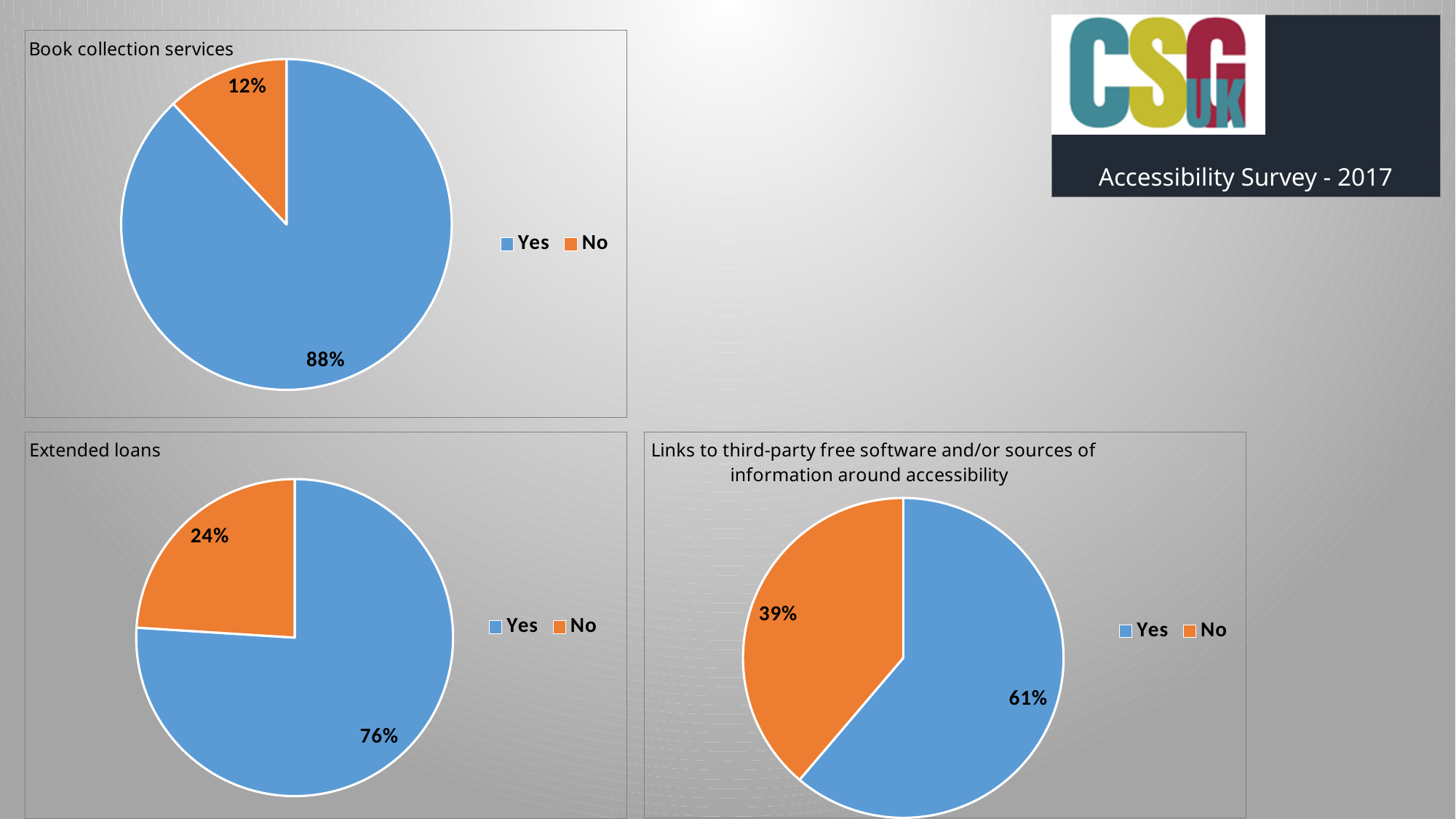
In the 'Book collection services' chart, what percentage answered No? 12% In the 'Links to third-party free software and/or sources of information around accessibility' chart, what percentage answered No? 39% In the 'Book collection services' chart, what percentage answered Yes? 88% How many entries does the legend of the 'Book collection services' chart list? 2 In the 'Extended loans' chart, which response has the larger share? Yes What type of chart is the 'Extended loans' chart? Pie chart In the 'Links to third-party free software and/or sources of information around accessibility' chart, what colour is the No slice? Orange In the 'Extended loans' chart, what percentage answered No? 24% In the 'Extended loans' chart, what percentage answered Yes? 76% In the 'Links to third-party free software and/or sources of information around accessibility' chart, what percentage answered Yes? 61% In the 'Book collection services' chart, which response has the smaller share? No In the 'Links to third-party free software and/or sources of information around accessibility' chart, what is the difference between the Yes and No percentages? 22%